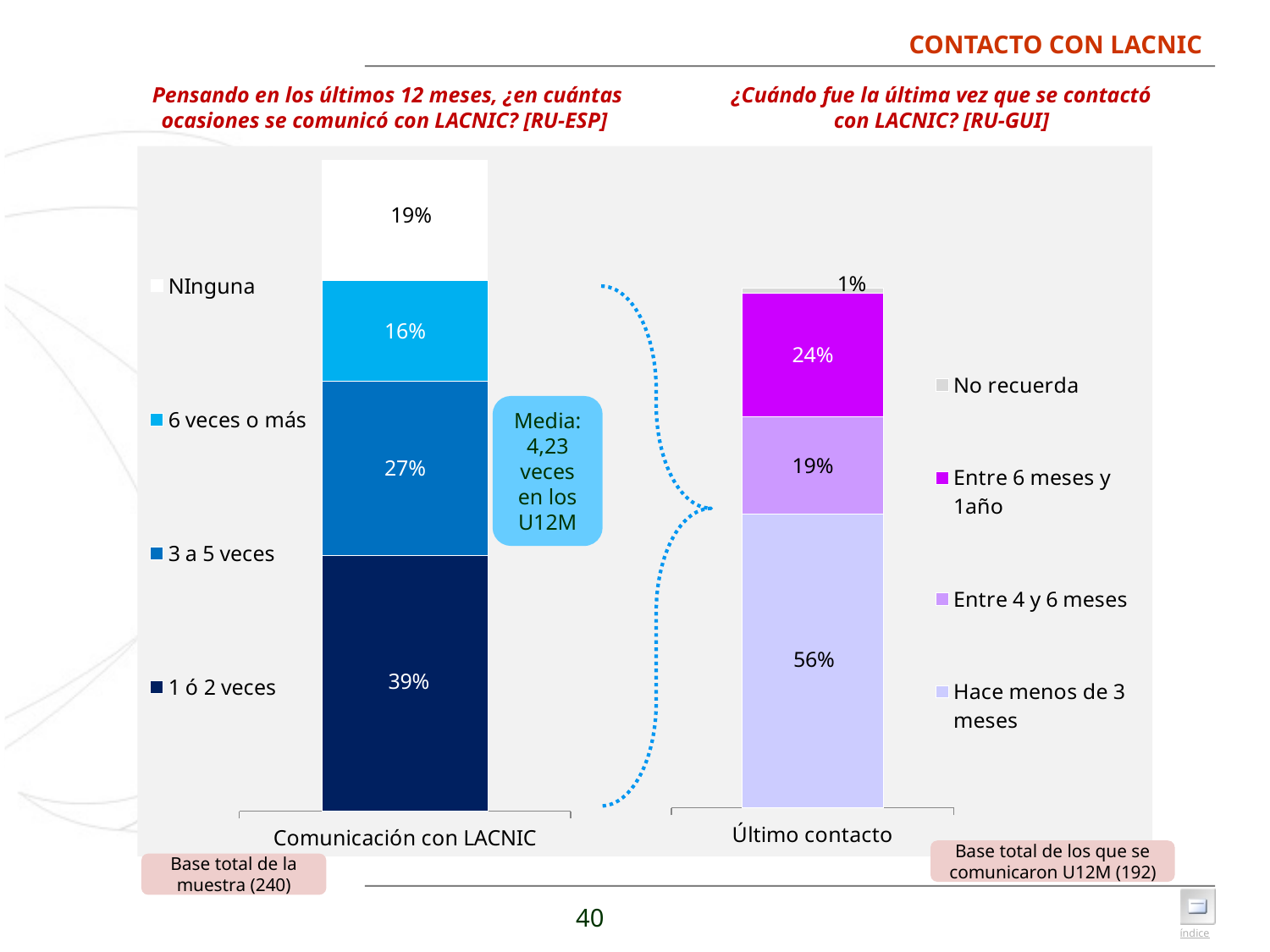
In the left chart (Comunicación con LACNIC), what is the difference between '1 ó 2 veces' and '3 a 5 veces'? 12% In the left chart (Comunicación con LACNIC), what percentage corresponds to '1 ó 2 veces'? 39% What type of chart is used on the left (Comunicación con LACNIC)? Stacked bar chart In the right chart (Último contacto), what percentage corresponds to 'Hace menos de 3 meses'? 56% What mean value is shown in the callout box between the two charts? Media: 4,23 veces en los U12M In the left chart (Comunicación con LACNIC), which category has the smallest share? 6 veces o más How many segments make up the stacked bar in the right chart (Último contacto)? 4 In the right chart (Último contacto), what percentage corresponds to 'No recuerda'? 1% In the left chart (Comunicación con LACNIC), which category has the largest share? 1 ó 2 veces In the right chart (Último contacto), what is the difference between 'Hace menos de 3 meses' and 'Entre 6 meses y 1año'? 32% In the right chart (Último contacto), which is larger: 'Entre 6 meses y 1año' or 'Entre 4 y 6 meses'? Entre 6 meses y 1año In the left chart (Comunicación con LACNIC), what percentage corresponds to 'NInguna'? 19%